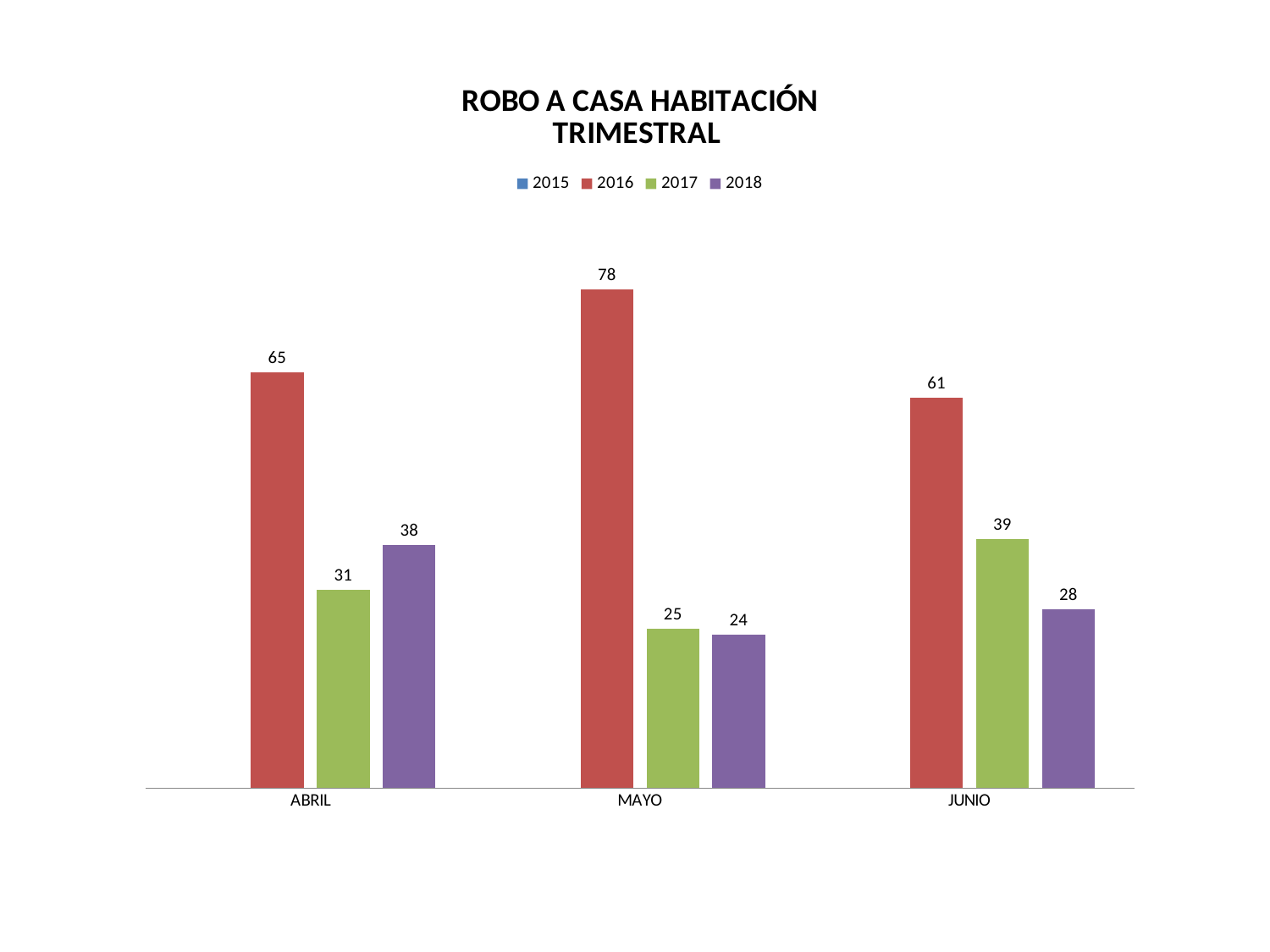
What is the value for 2017 in ABRIL? 31 In which month is the 2016 value highest? MAYO What is the title of the chart? ROBO A CASA HABITACIÓN TRIMESTRAL What kind of chart is this? Bar chart What is the difference between the 2016 and 2017 values in JUNIO? 22 What is the value for 2018 in JUNIO? 28 How many series does the legend list? 4 What is the difference between the 2016 values for MAYO and ABRIL? 13 How many months are shown on the x axis? 3 In which month is the 2018 value lowest? MAYO What is the value for 2016 in MAYO? 78 Which is larger in ABRIL, the 2017 value or the 2018 value? 2018